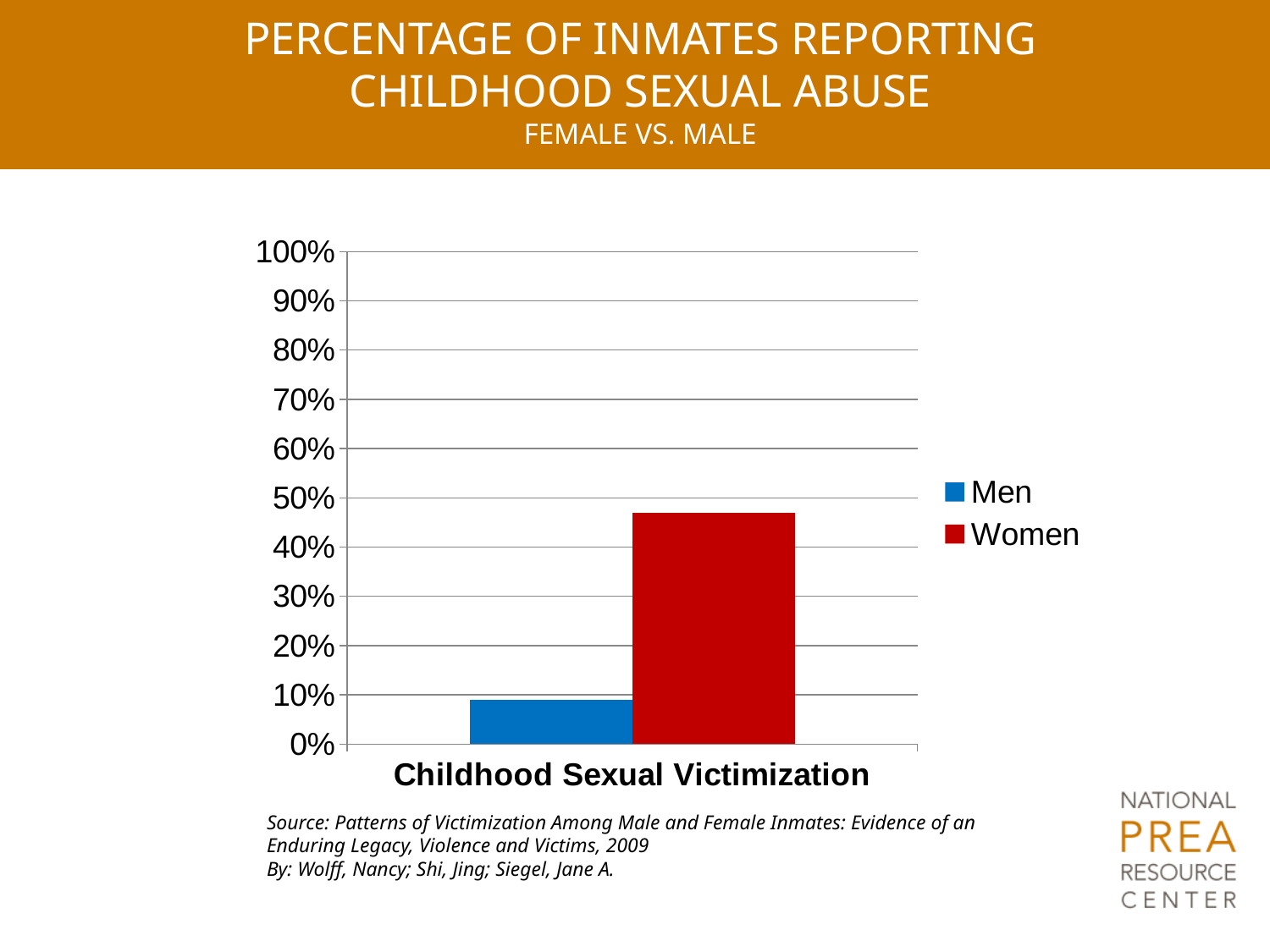
What kind of chart is shown on the slide? bar chart Which colour represents the Women series in the legend? red Which series has the higher value for Childhood Sexual Victimization, Men or Women? Women Is the value for Women greater or less than 40%? greater Which series has the lowest bar in the chart? Men What is the label of the category on the x axis? Childhood Sexual Victimization Is the value for Men greater or less than 20%? less Is the value for Men greater or less than 30%? less Which series has the highest bar in the chart? Women How many series does the legend list? 2 How many categories are shown on the x axis? 1